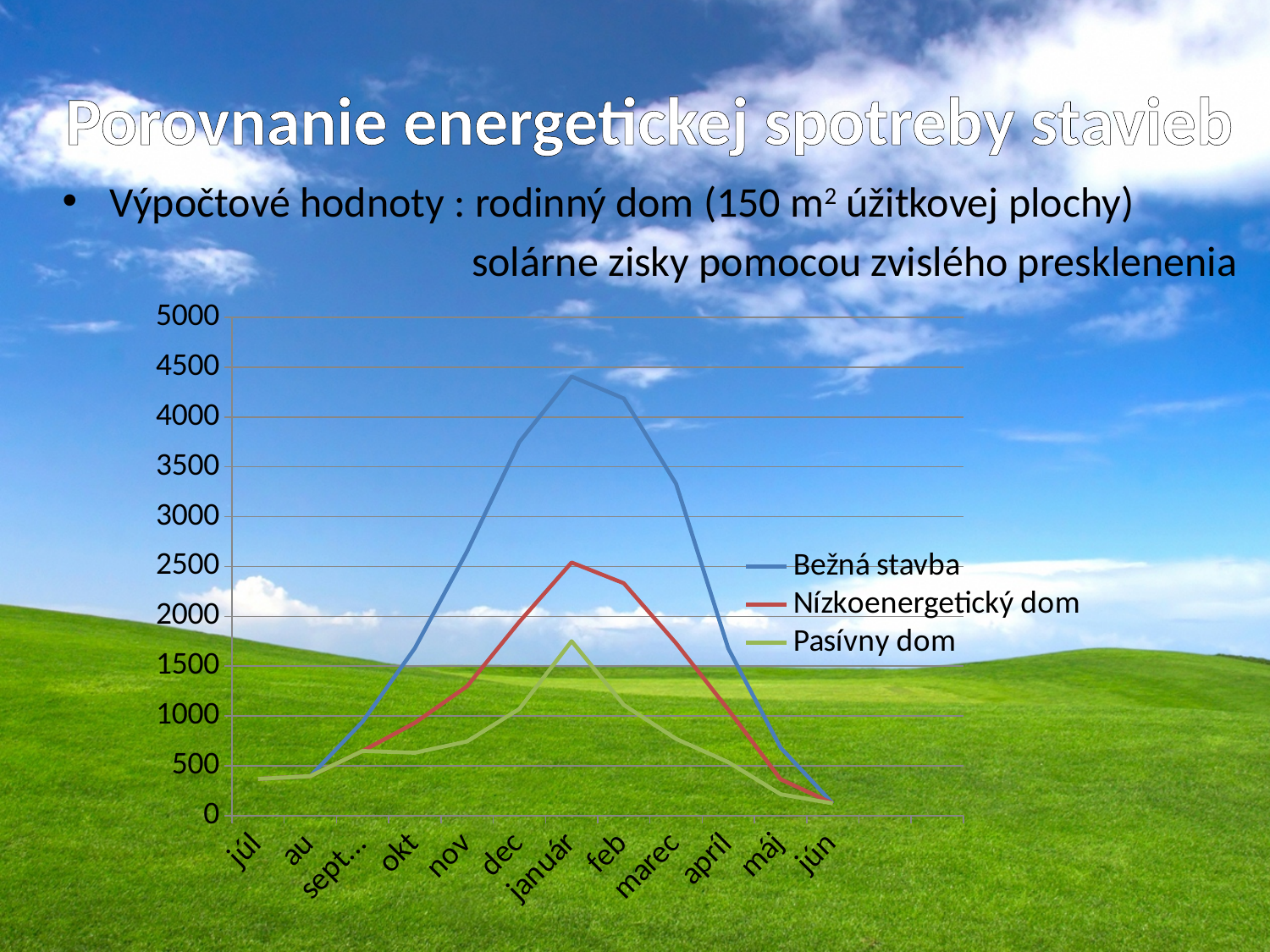
Which series has the highest value in január? Bežná stavba Is the value for Nízkoenergetický dom in január greater or less than 2000? greater Is the value for Bežná stavba in január greater or less than 4000? greater Is the value for Bežná stavba in júl greater or less than 500? less What kind of chart is shown on the slide? line chart In nov, which series has the larger value: Nízkoenergetický dom or Pasívny dom? Nízkoenergetický dom How many series does the legend list? 3 Do the values for Bežná stavba rise or fall from január to jún? fall In which month does the Bežná stavba series reach its highest value? január Which colour is used for the Nízkoenergetický dom series? red How many months are shown along the x axis? 12